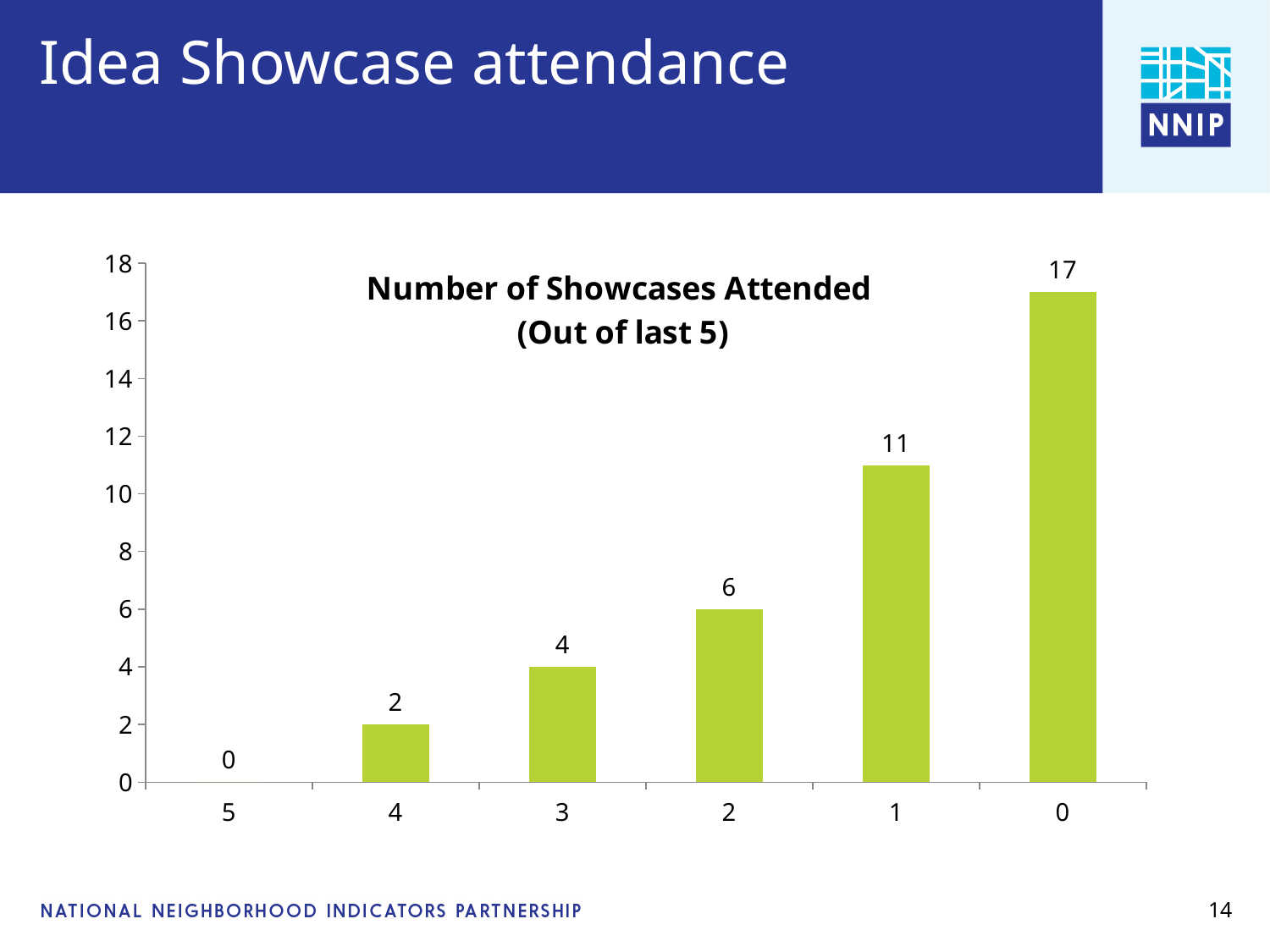
What is the title of the chart? Number of Showcases Attended (Out of last 5) Which is larger, the value for category 2 or the value for category 4? 2 What is the value for the category 3 (showcases attended)? 4 What is the value for the category 0 (showcases attended)? 17 What is the value for the category 5 (showcases attended)? 0 What kind of chart is shown on the slide? bar chart Which category has the highest value? 0 Is the value for category 1 greater or less than 10? greater What is the difference between the values for categories 0 and 1? 6 How many categories are shown on the x axis? 6 Which category has the lowest value? 5 Do the values rise or fall moving from left to right along the x axis? rise